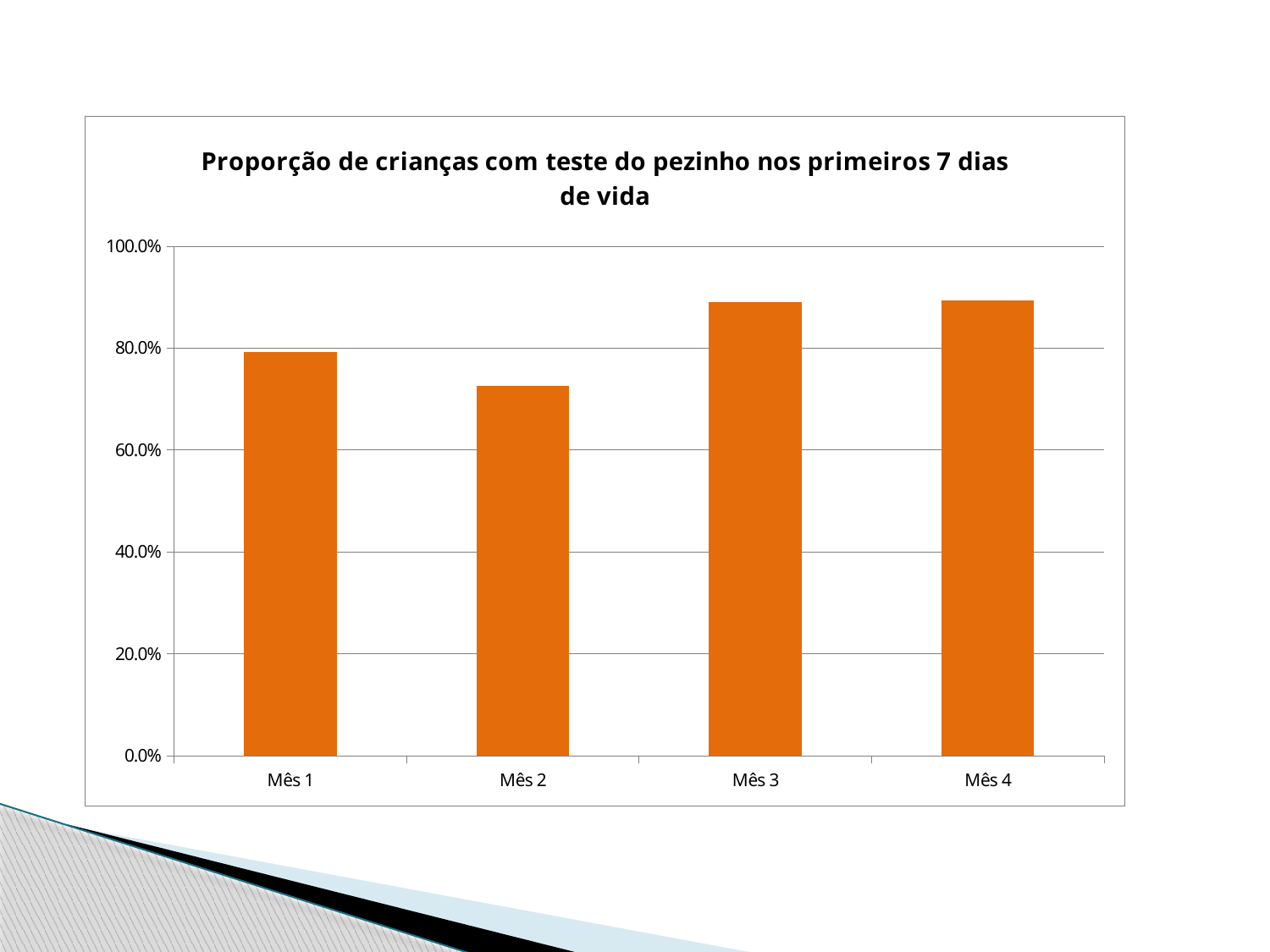
Is the value for Mês 2 greater or less than 60.0%? greater Is the value for Mês 3 greater or less than 80.0%? greater How many categories (months) are shown on the x axis? 4 Is the value for Mês 4 greater or less than 80.0%? greater Which is larger, the value for Mês 1 or the value for Mês 2? Mês 1 Which is larger, the value for Mês 3 or the value for Mês 2? Mês 3 Which month has the lowest proportion? Mês 2 What kind of chart is shown on the slide? bar chart Does the value rise or fall from Mês 2 to Mês 3? rise What is the title of the chart? Proporção de crianças com teste do pezinho nos primeiros 7 dias de vida